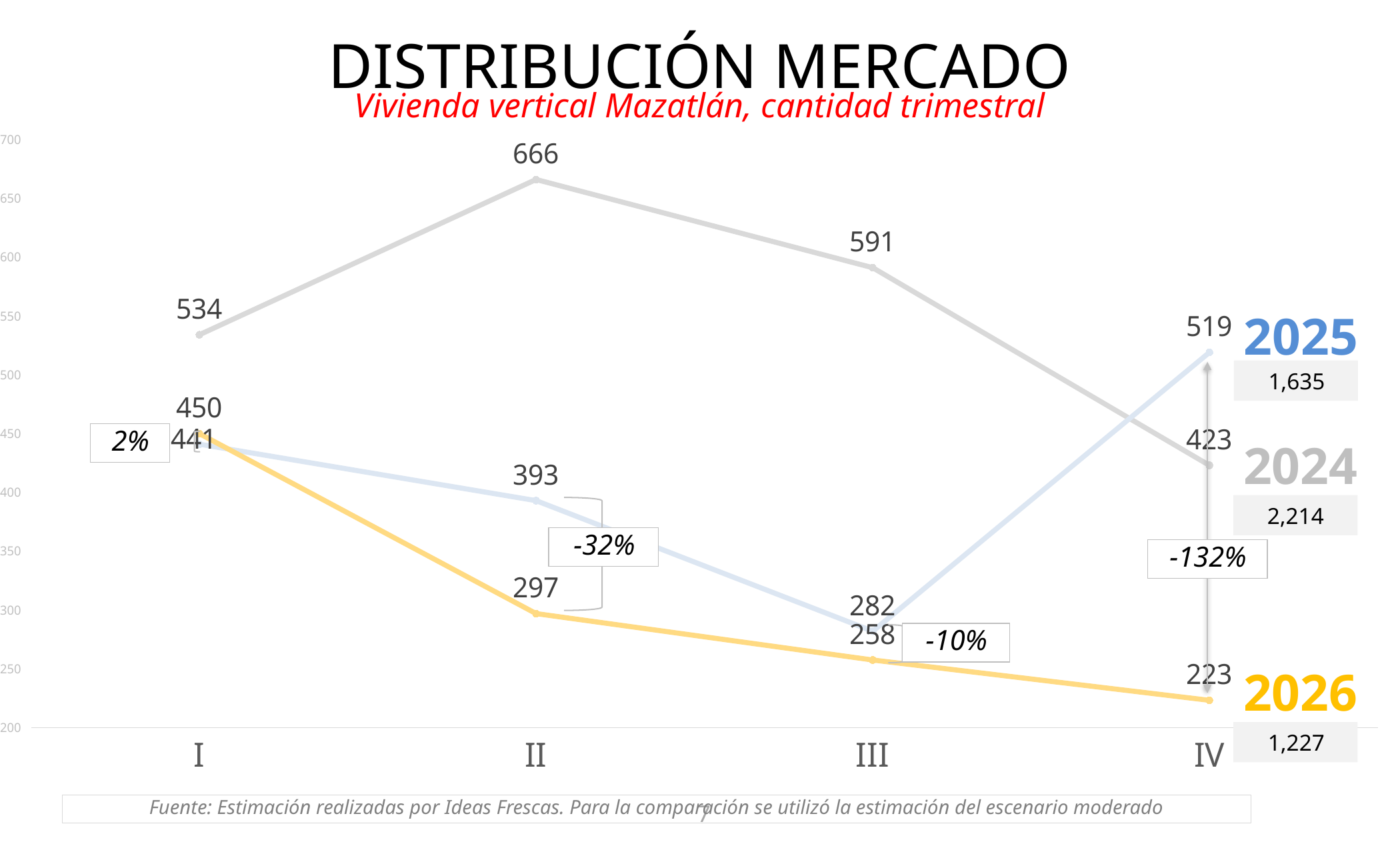
In which quarter does the 2024 series reach its highest value? II What is the value for the 2025 series in quarter IV? 519 How many series (years) are plotted on the chart? 3 What is the value for the 2026 series in quarter IV? 223 In which quarter does the 2026 series reach its lowest value? IV What type of chart is shown on the slide? line chart What is the difference between the 2024 and 2025 values in quarter III? 309 Which series has the larger value in quarter IV, 2024 or 2025? 2025 What is the value for the 2024 series in quarter I? 534 What annual total is shown for the 2024 series? 2,214 What is the value for the 2024 series in quarter II? 666 How many quarters are shown on the x axis? 4